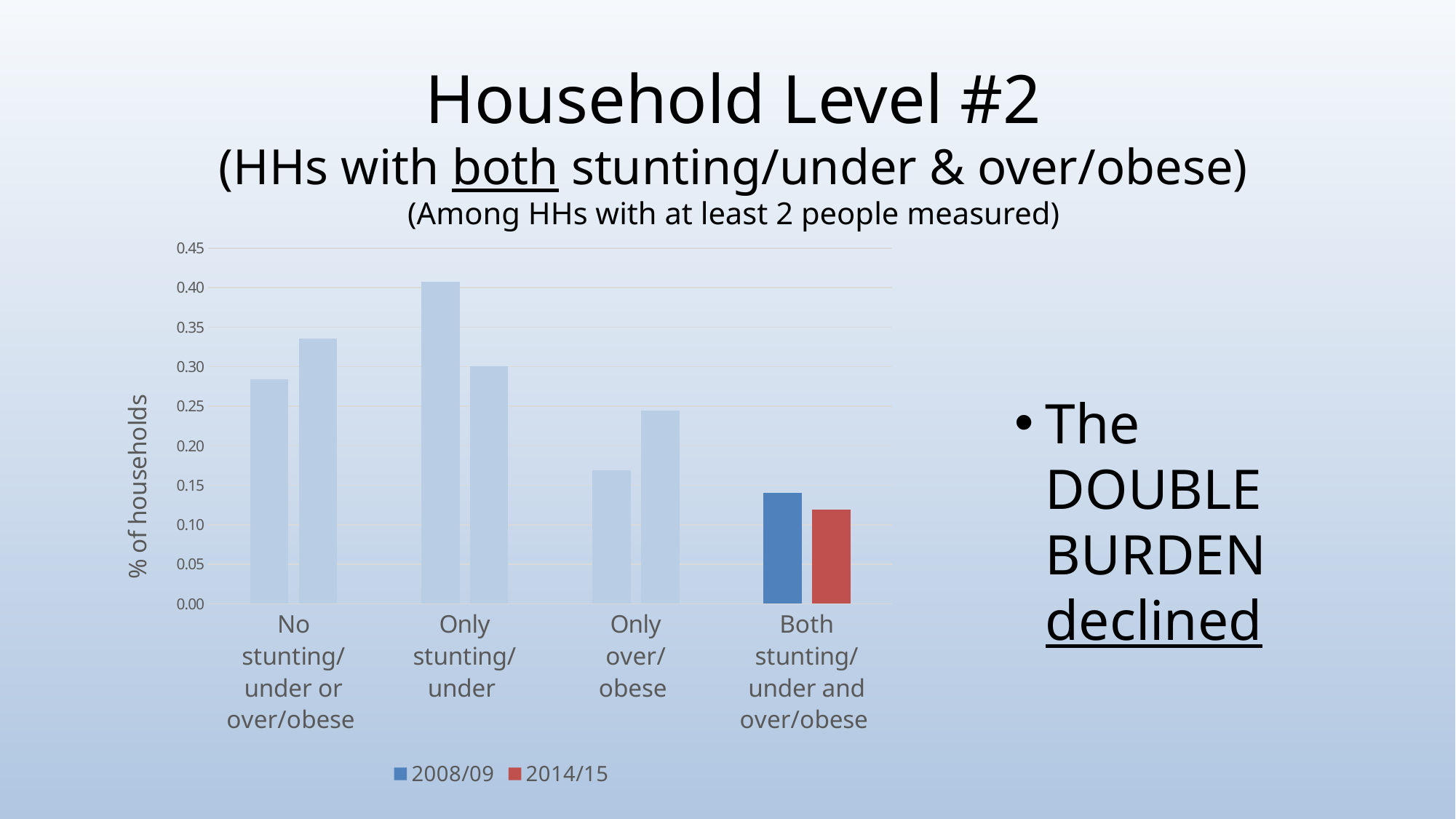
Which category has the highest bar in the chart? Only stunting/under What kind of chart is shown on the slide? bar chart Do the 2014/15 values rise or fall moving from left to right across the categories? fall What is the label on the chart's vertical axis? % of households For the 'Both stunting/under and over/obese' category, which series has the larger value, 2008/09 or 2014/15? 2008/09 Is the 2008/09 value for 'Only stunting/under' greater or less than 0.35? greater Is the 2014/15 value for 'Both stunting/under and over/obese' greater or less than 0.15? less How many categories are shown on the x axis of the chart? 4 Is the 2014/15 value for 'No stunting/under or over/obese' greater or less than 0.30? greater How many series does the chart's legend list? 2 Which category has the lowest bar in the chart? Both stunting/under and over/obese For the 'Only stunting/under' category, which series has the larger value, 2008/09 or 2014/15? 2008/09